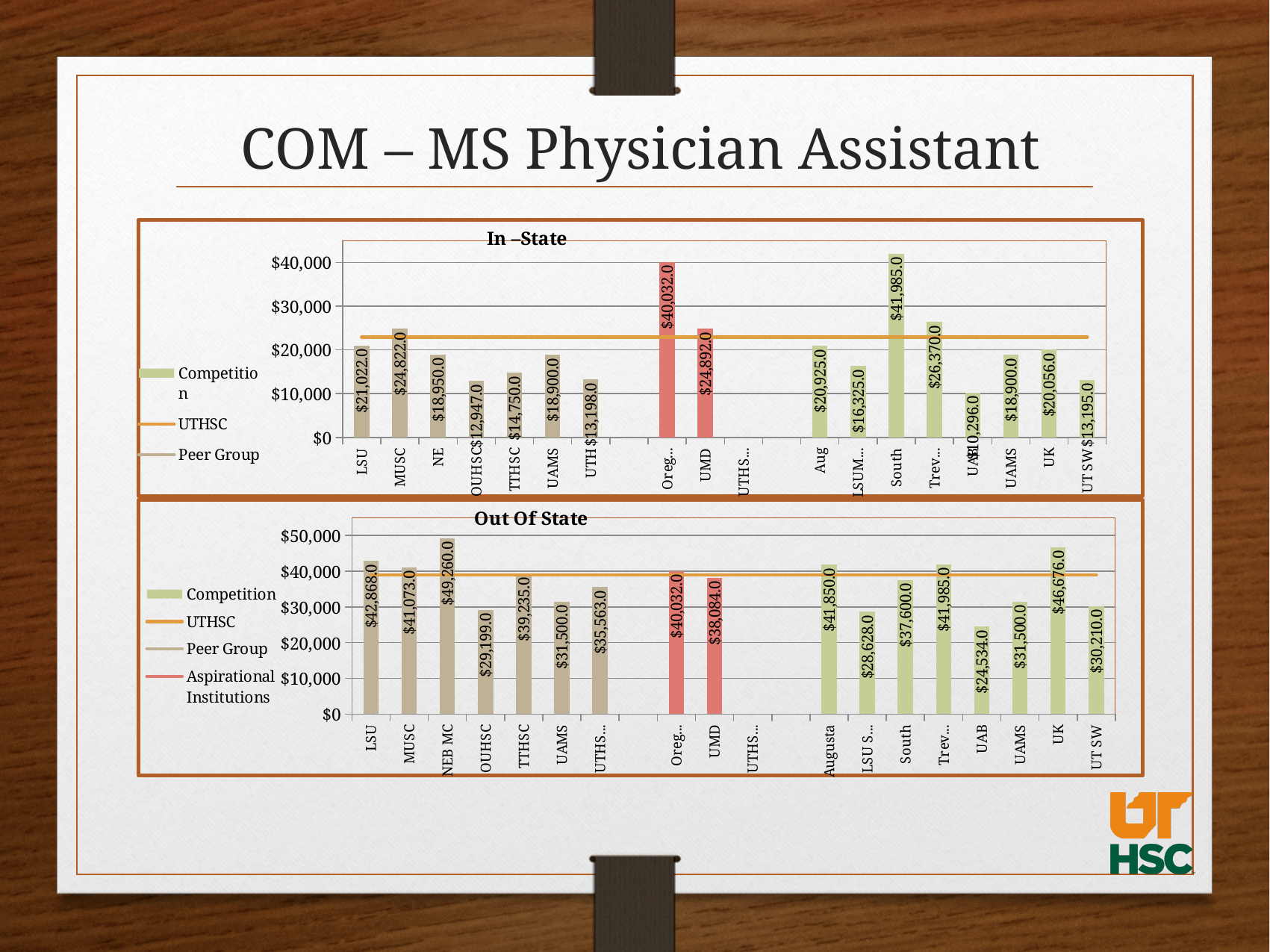
In the In-State chart, what is the difference between the Oreg... bar and the UMD bar? $15,140.0 In the Out Of State chart, which institution has the lowest bar? UAB In the In-State chart, which is larger, the value for LSU or the value for NE? LSU In the Out Of State chart, which institution has the highest bar? NEB MC How many entries does the legend of the Out Of State chart list? 4 In the Out Of State chart, what is the difference between the UK bar and the UAB bar? $22,142.0 In the Out Of State chart, what is the value for NEB MC? $49,260.0 In the In-State chart, is the UTHSC line greater or less than $20,000? greater In the In-State chart, which institution has the lowest bar? UAB What kind of chart is the Out Of State chart? bar chart In the In-State chart, what is the value for MUSC? $24,822.0 In the In-State chart, which institution has the highest bar? South